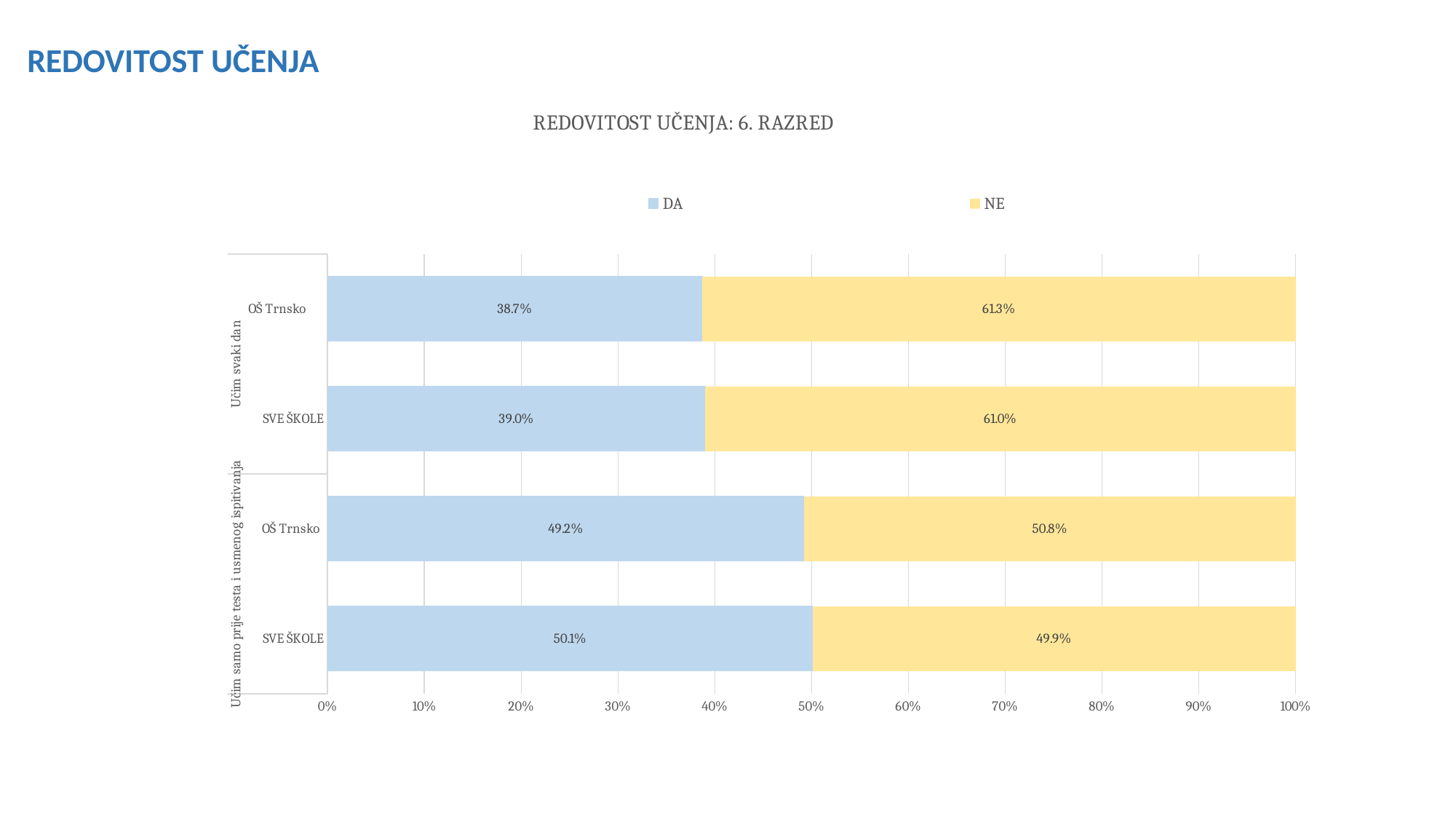
What is the NE value for SVE ŠKOLE under "Učim samo prije testa i usmenog ispitivanja"? 49.9% What is the DA value for OŠ Trnsko under "Učim svaki dan"? 38.7% How many bars are shown in the chart? 4 Which bar has the lowest DA value? OŠ Trnsko (Učim svaki dan) Which bar has the highest DA value? SVE ŠKOLE (Učim samo prije testa i usmenog ispitivanja) Under "Učim samo prije testa i usmenog ispitivanja", is the DA value for OŠ Trnsko or for SVE ŠKOLE larger? SVE ŠKOLE What is the NE value for SVE ŠKOLE under "Učim svaki dan"? 61.0% What kind of chart is shown? Stacked bar chart What is the difference between the NE and DA values for OŠ Trnsko under "Učim svaki dan"? 22.6% How many series does the legend list? 2 What is the title of the chart? REDOVITOST UČENJA: 6. RAZRED What is the DA value for OŠ Trnsko under "Učim samo prije testa i usmenog ispitivanja"? 49.2%